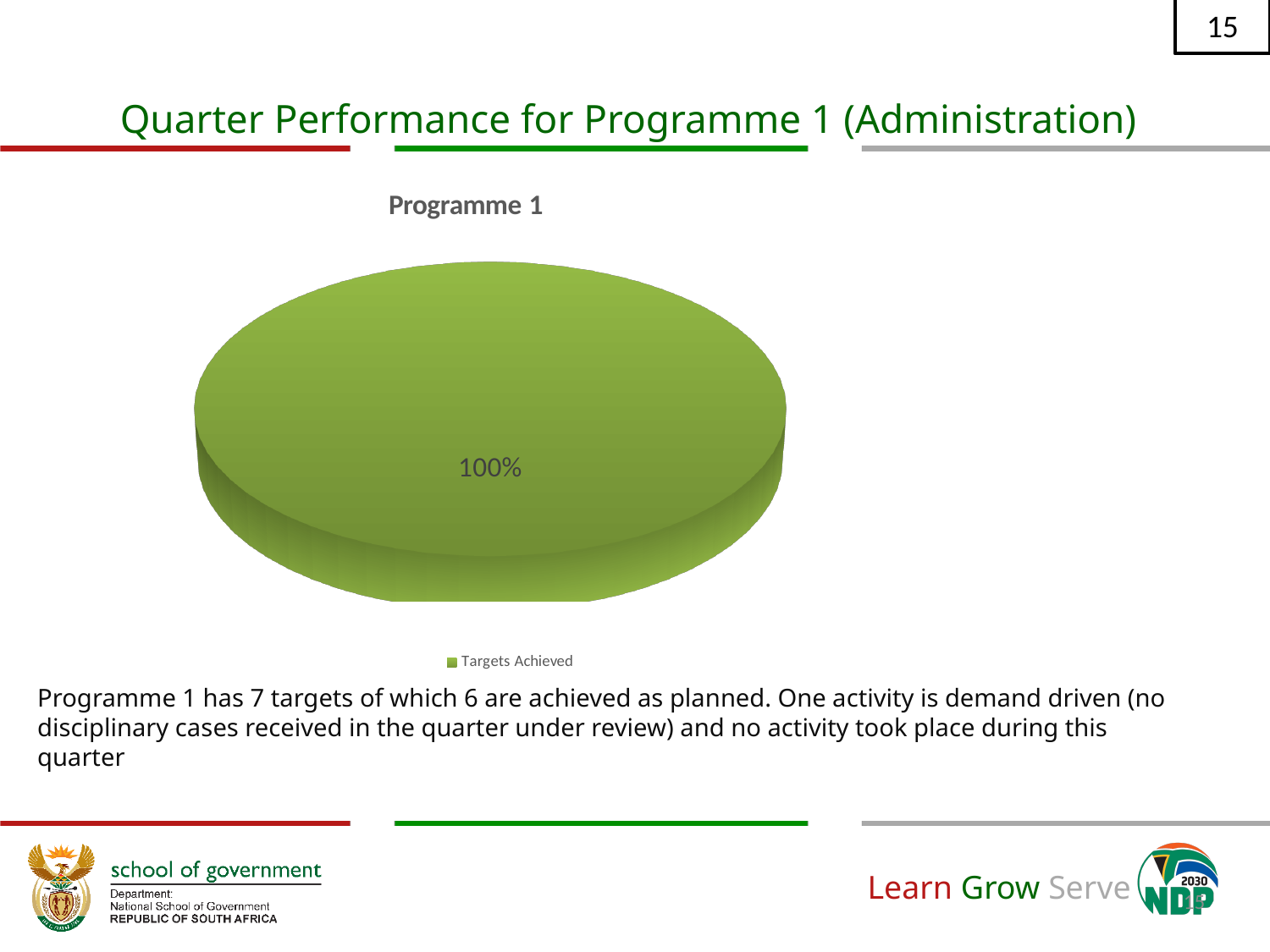
What value is printed on the pie slice? 100% Is the value for Targets Achieved greater or less than 50%? greater How many entries does the legend list? 1 What share of the pie does the Targets Achieved slice represent? 100% How many slices does the pie chart have? 1 What kind of chart is shown on the slide? pie chart What is the title of the chart? Programme 1 What is the legend entry for the pie chart? Targets Achieved